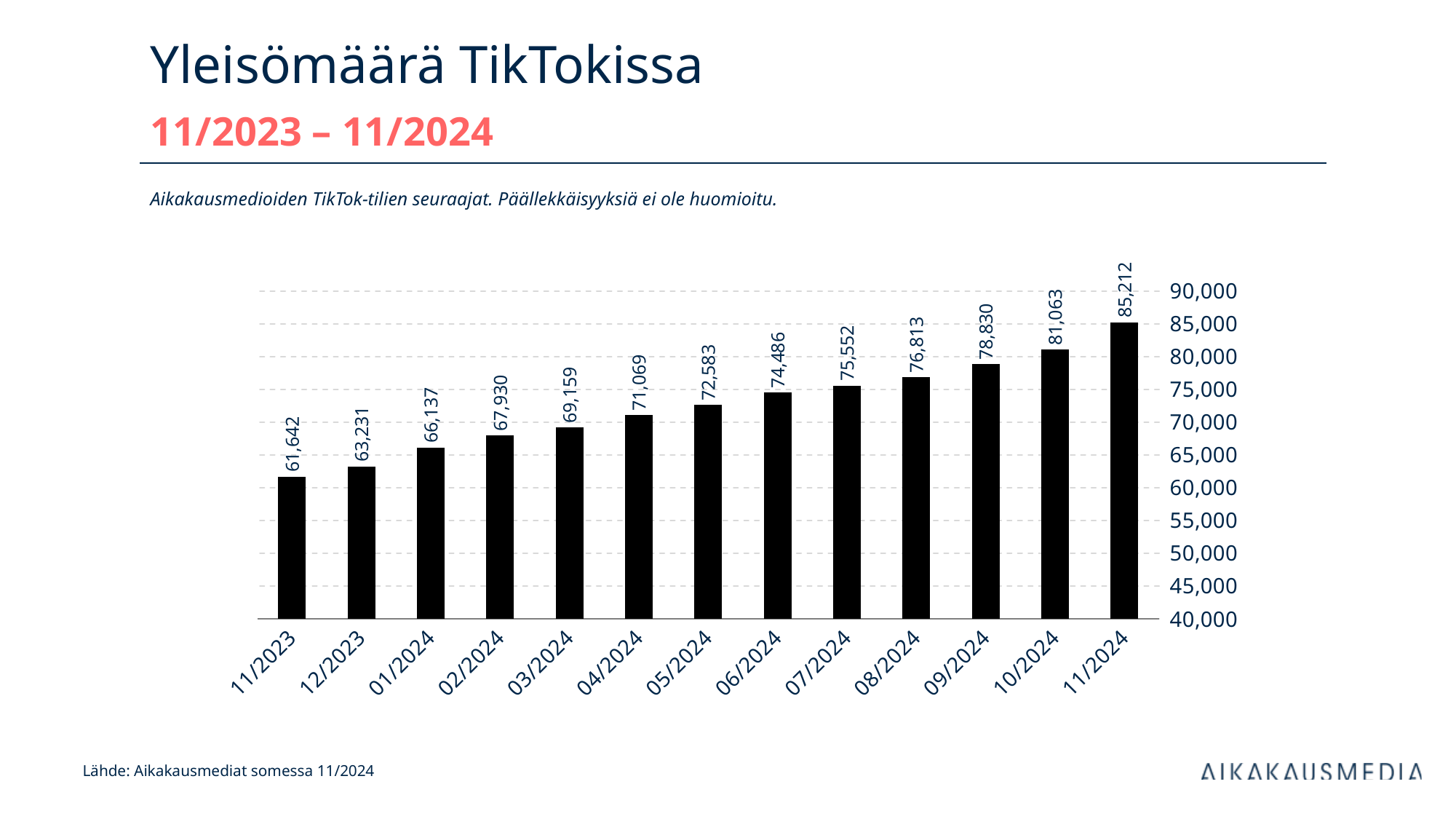
Do the values rise or fall from 11/2023 to 11/2024? rise Which month has the lowest value? 11/2023 What kind of chart is shown on the slide? bar chart What is the value for 11/2023? 61,642 How many months are shown on the x axis? 13 Is the value for 08/2024 greater or less than 75,000? greater What is the value for 05/2024? 72,583 What is the difference between the values for 10/2024 and 09/2024? 2,233 Which is larger, the value for 03/2024 or the value for 07/2024? 07/2024 Which month has the highest value? 11/2024 What is the value for 11/2024? 85,212 What is the difference between the values for 11/2024 and 11/2023? 23,570